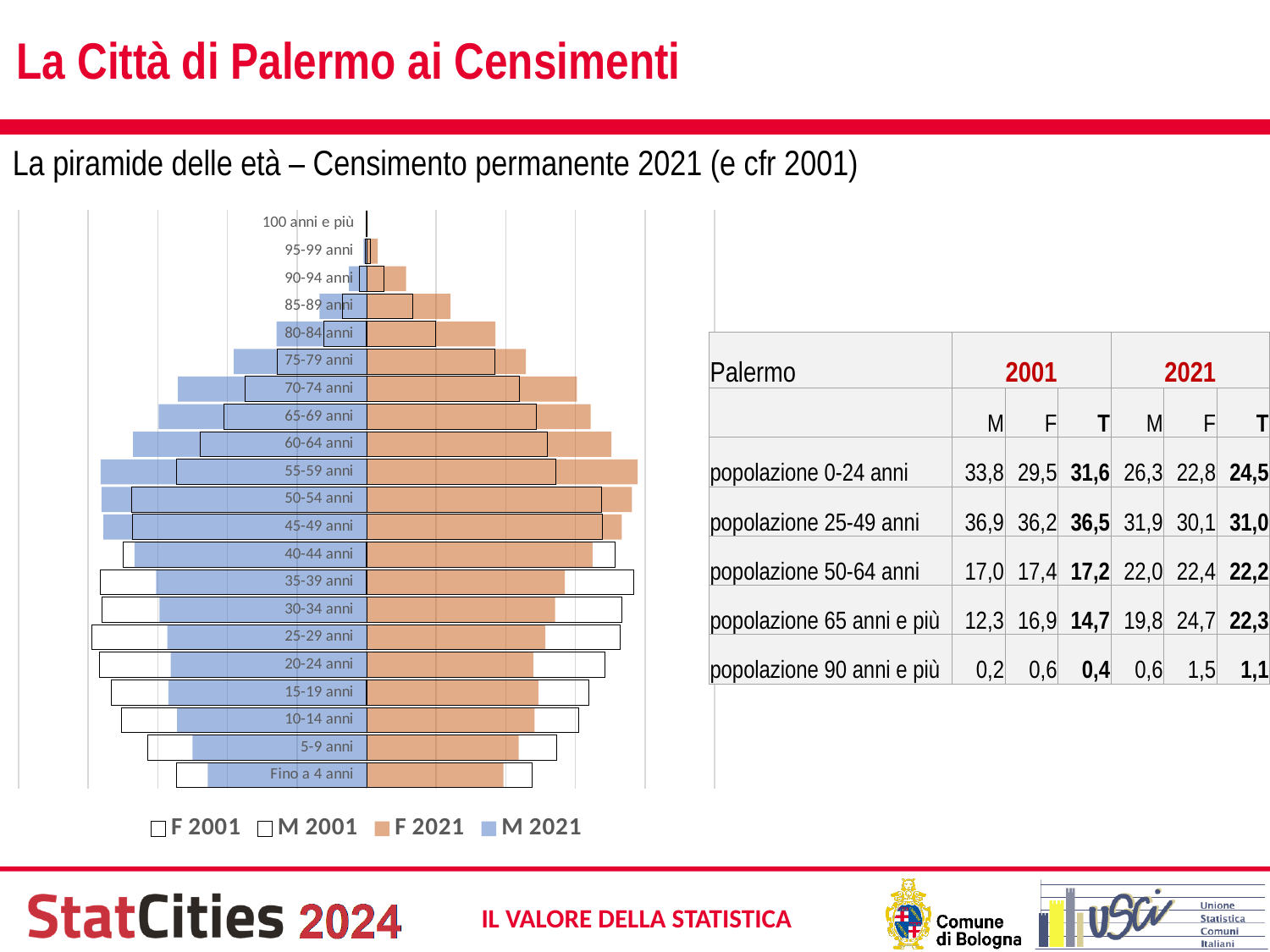
What kind of chart is shown on the left of the slide? bar chart In the age pyramid chart, is the M 2021 bar for 45-49 anni larger or smaller than the M 2021 bar for 5-9 anni? larger Which colour represents the F 2021 series in the age pyramid chart? orange In the age pyramid chart, is the F 2021 bar for 50-54 anni larger or smaller than the F 2021 bar for 85-89 anni? larger In the age pyramid chart, for the 70-74 anni group, which is larger: the F 2001 bar or the F 2021 bar? F 2021 How many series does the legend of the age pyramid chart list? 4 In the age pyramid chart, do the M 2021 bars get longer or shorter going from 45-49 anni up to 100 anni e più? shorter How many age groups are shown on the age pyramid chart? 21 Which age group has the smallest bars for every series in the age pyramid chart? 100 anni e più Which colour represents the M 2021 series in the age pyramid chart? blue